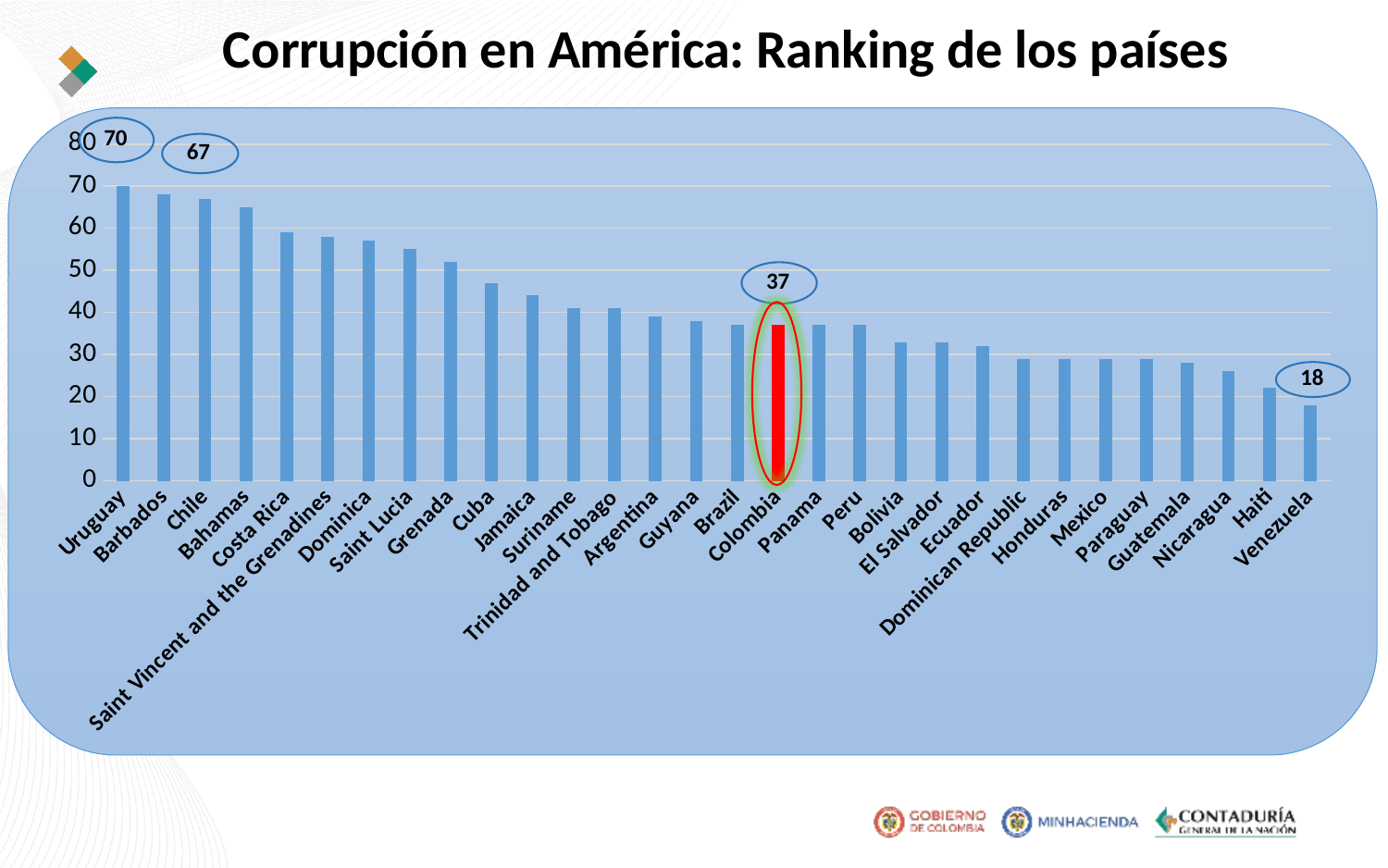
Is the value for Costa Rica greater or less than 50? greater What is the value for Venezuela? 18 What kind of chart is shown on the slide? Bar chart Is the value for Haiti greater or less than 30? less What is the value for Uruguay? 70 Which country has the highest value? Uruguay What is the value for Colombia? 37 How many countries are shown in the chart? 30 What is the difference between the values for Uruguay and Colombia? 33 Which country has the lowest value? Venezuela What is the difference between the values for Colombia and Venezuela? 19 Which has a larger value, Chile or Cuba? Chile